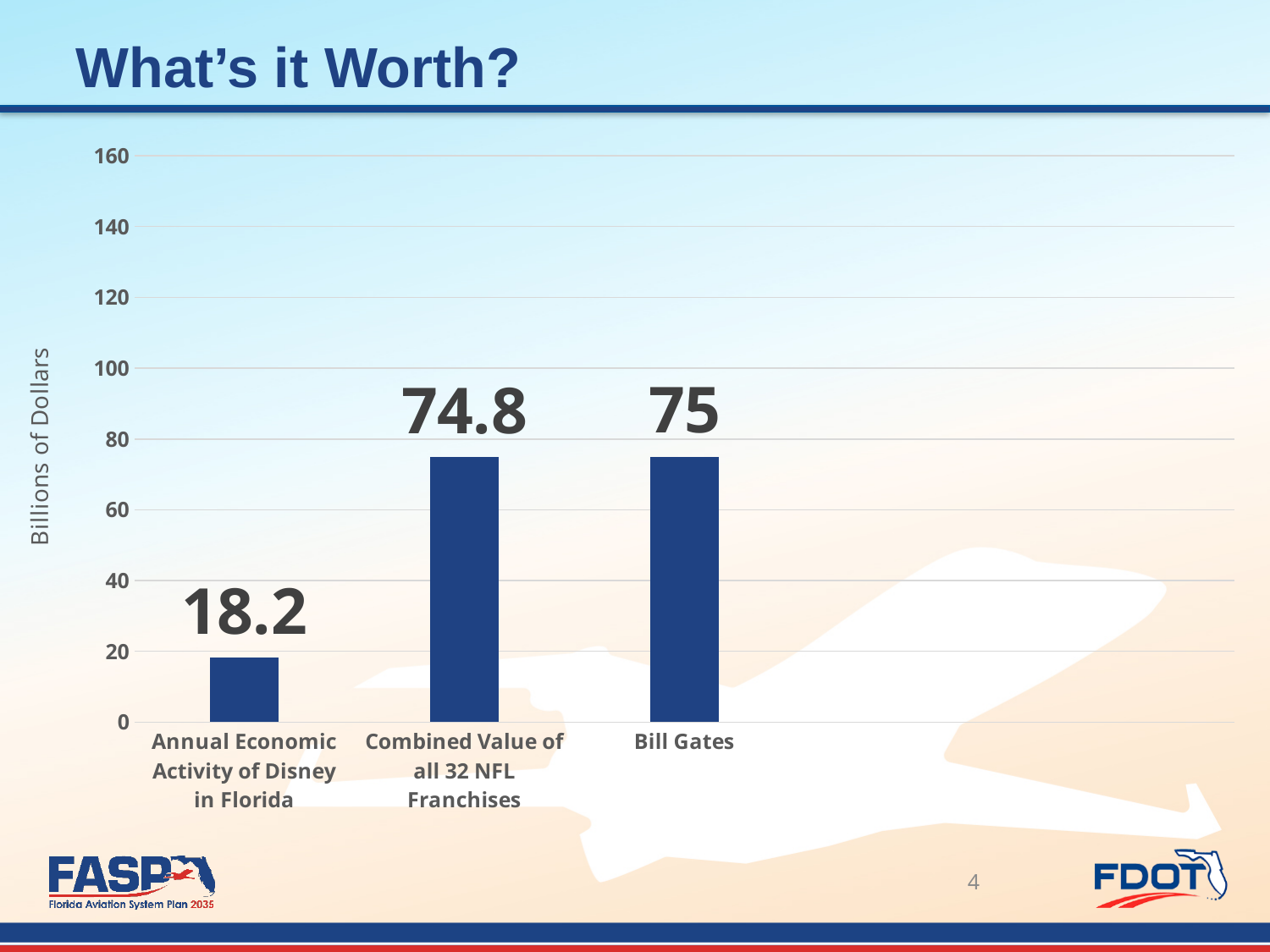
What kind of chart is shown on the slide? bar chart What is the value shown for Bill Gates? 75 Which is larger, the value for Bill Gates or the value for Annual Economic Activity of Disney in Florida? Bill Gates What is the difference between the value for Bill Gates and the value for Combined Value of all 32 NFL Franchises? 0.2 What is the difference between the value for Bill Gates and the value for Annual Economic Activity of Disney in Florida? 56.8 Is the value for Combined Value of all 32 NFL Franchises greater or less than 80? less What is the value shown for Annual Economic Activity of Disney in Florida? 18.2 What is the value shown for Combined Value of all 32 NFL Franchises? 74.8 Which category has the lowest value? Annual Economic Activity of Disney in Florida How many categories are shown in the chart? 3 Is the value for Annual Economic Activity of Disney in Florida greater or less than 40? less What is the label on the vertical axis of the chart? Billions of Dollars